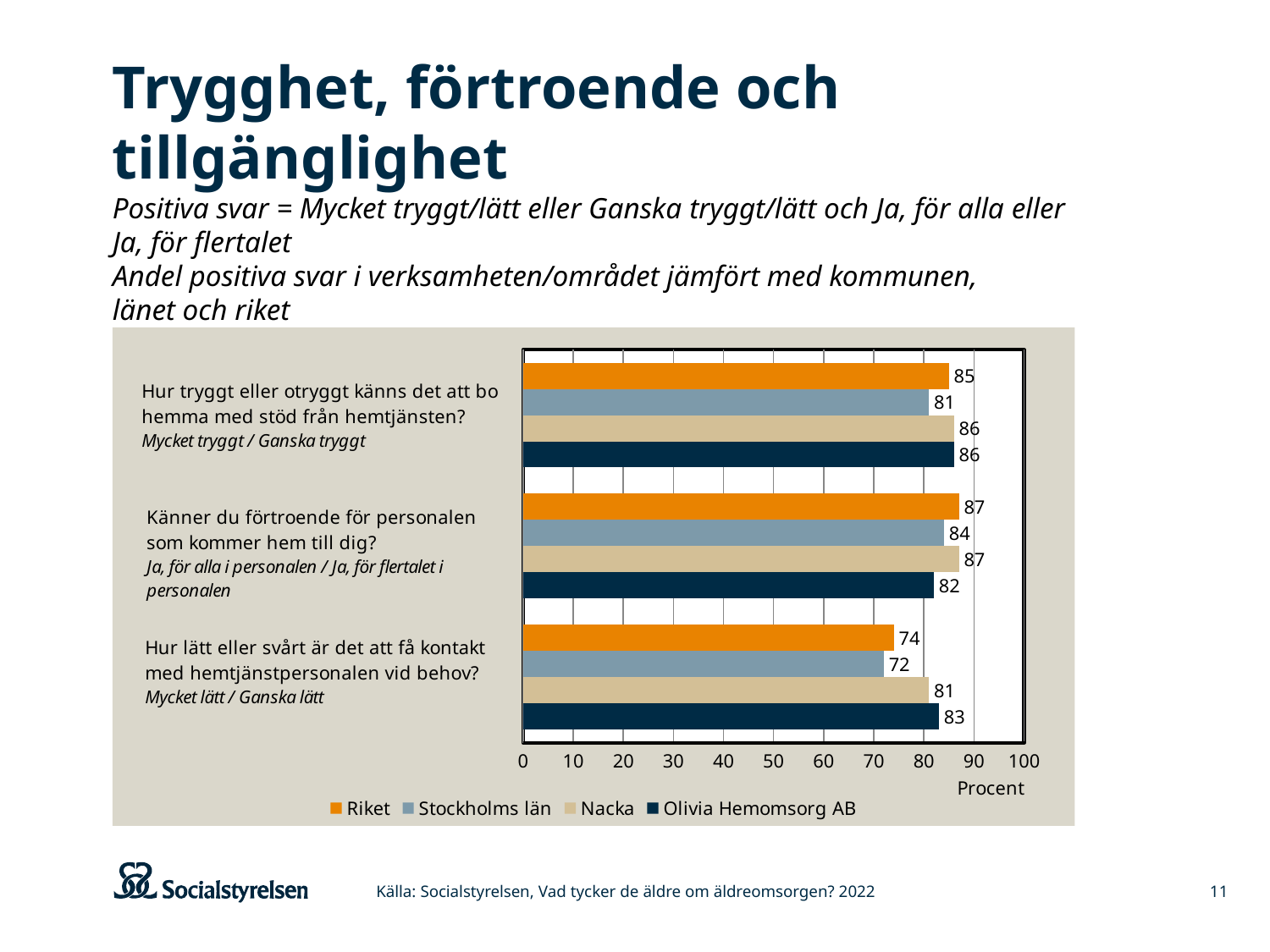
Is the value for Riket on the question 'Hur lätt eller svårt är det att få kontakt med hemtjänstpersonalen vid behov?' greater or less than 80? less What is the value for Riket on the question 'Känner du förtroende för personalen som kommer hem till dig?' 87 What is the value for Olivia Hemomsorg AB on the question 'Hur lätt eller svårt är det att få kontakt med hemtjänstpersonalen vid behov?' 83 What is the value for Stockholms län on the question 'Hur tryggt eller otryggt känns det att bo hemma med stöd från hemtjänsten?' 81 What kind of chart is shown on the slide? Bar chart What label is shown on the horizontal axis of the chart? Procent How many survey questions (categories) are plotted in the chart? 3 Which series has the lowest value on the question 'Känner du förtroende för personalen som kommer hem till dig?' Olivia Hemomsorg AB What is the difference between Olivia Hemomsorg AB and Riket on the question 'Hur lätt eller svårt är det att få kontakt med hemtjänstpersonalen vid behov?' 9 Which series has the lowest value on the question 'Hur lätt eller svårt är det att få kontakt med hemtjänstpersonalen vid behov?' Stockholms län How many series does the legend list? 4 On the question 'Känner du förtroende för personalen som kommer hem till dig?', which is larger: Stockholms län or Olivia Hemomsorg AB? Stockholms län